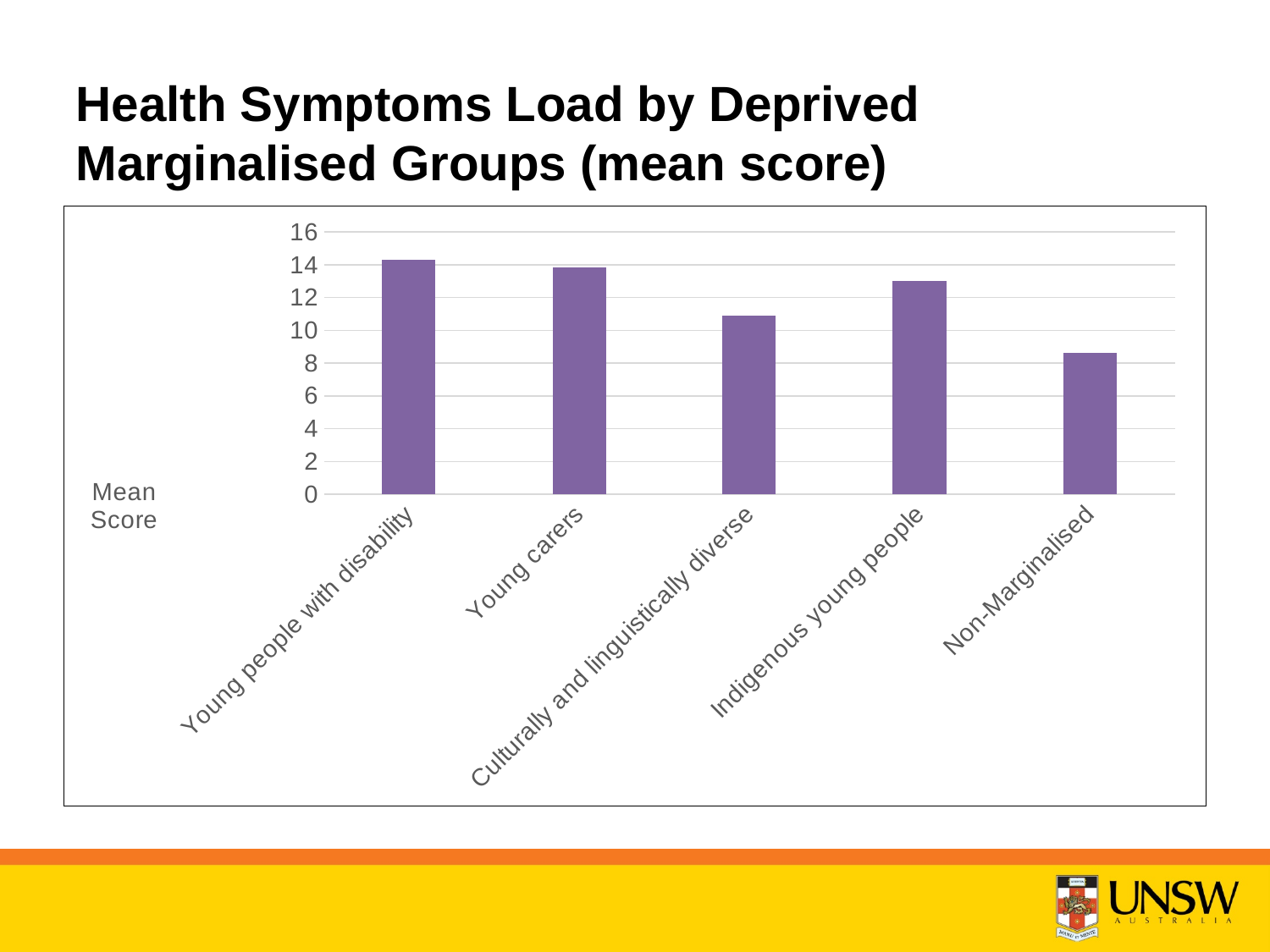
Which has a higher mean score, Indigenous young people or Non-Marginalised? Indigenous young people What is the label on the vertical axis of the chart? Mean Score Which group has the lowest mean health symptoms load score? Non-Marginalised What kind of chart is shown on the slide? Bar chart How many groups are plotted on the chart? 5 Is the value for Culturally and linguistically diverse greater or less than 10? greater Is the value for Young people with disability greater or less than 12? greater Which has a higher mean score, Young carers or Culturally and linguistically diverse? Young carers Is the value for Indigenous young people greater or less than 12? greater What is the title of the chart on the slide? Health Symptoms Load by Deprived Marginalised Groups (mean score)